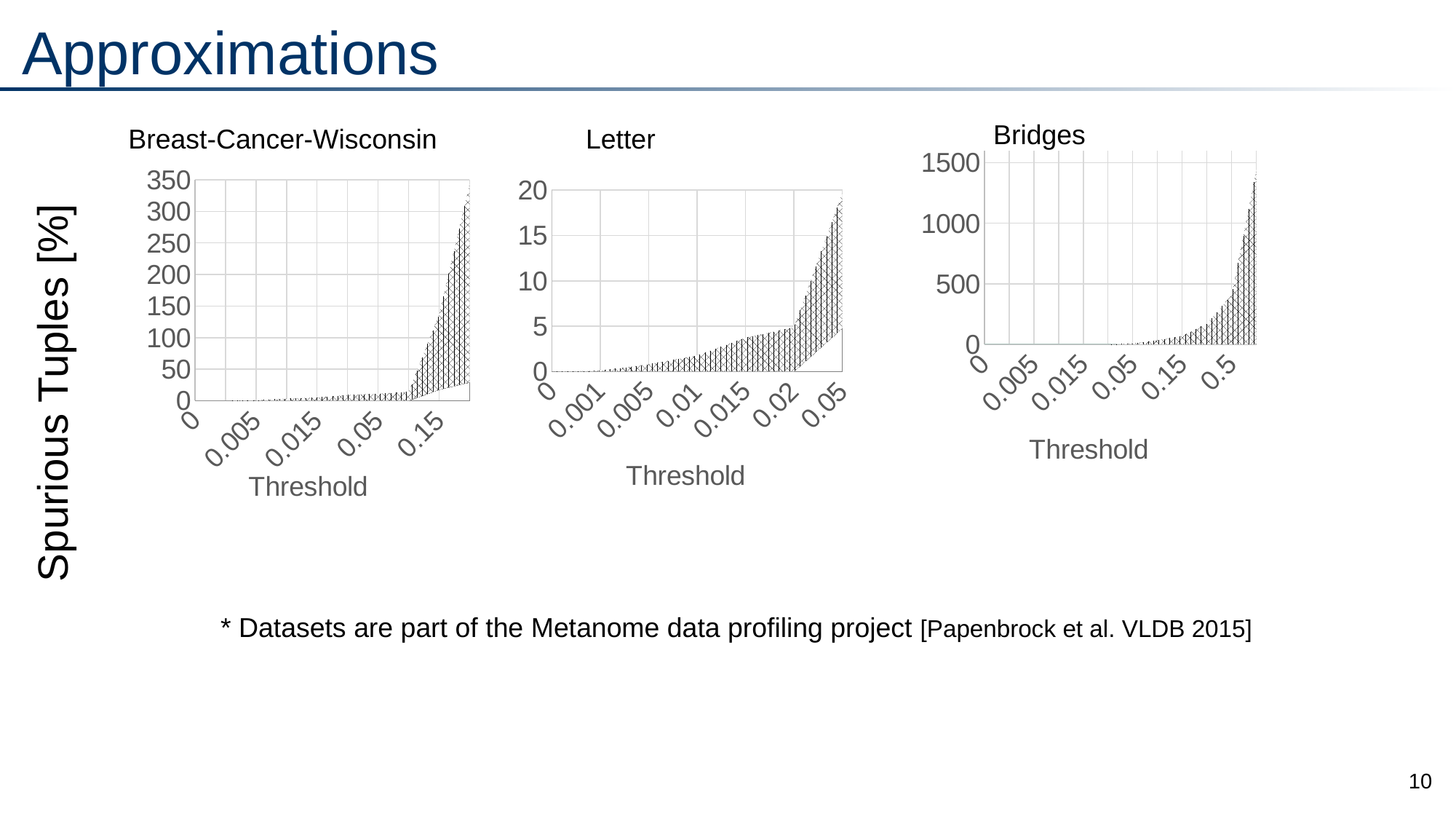
What is the x-axis label on the Bridges chart? Threshold What kind of chart is the Letter chart? area chart In the Bridges chart, is the value at threshold 0.05 greater or less than 500? less What is the highest tick value on the y axis of the Bridges chart? 1500 In the Letter chart, is the value at threshold 0.01 greater or less than 5? less In the Bridges chart, do the values rise or fall as the threshold increases along the x axis? rise What is the title of the leftmost chart? Breast-Cancer-Wisconsin In the Letter chart, do the values rise or fall as the threshold increases along the x axis? rise In the Letter chart, is the highest value reached at the right end of the x axis greater or less than 15? greater How many charts are shown on the slide? 3